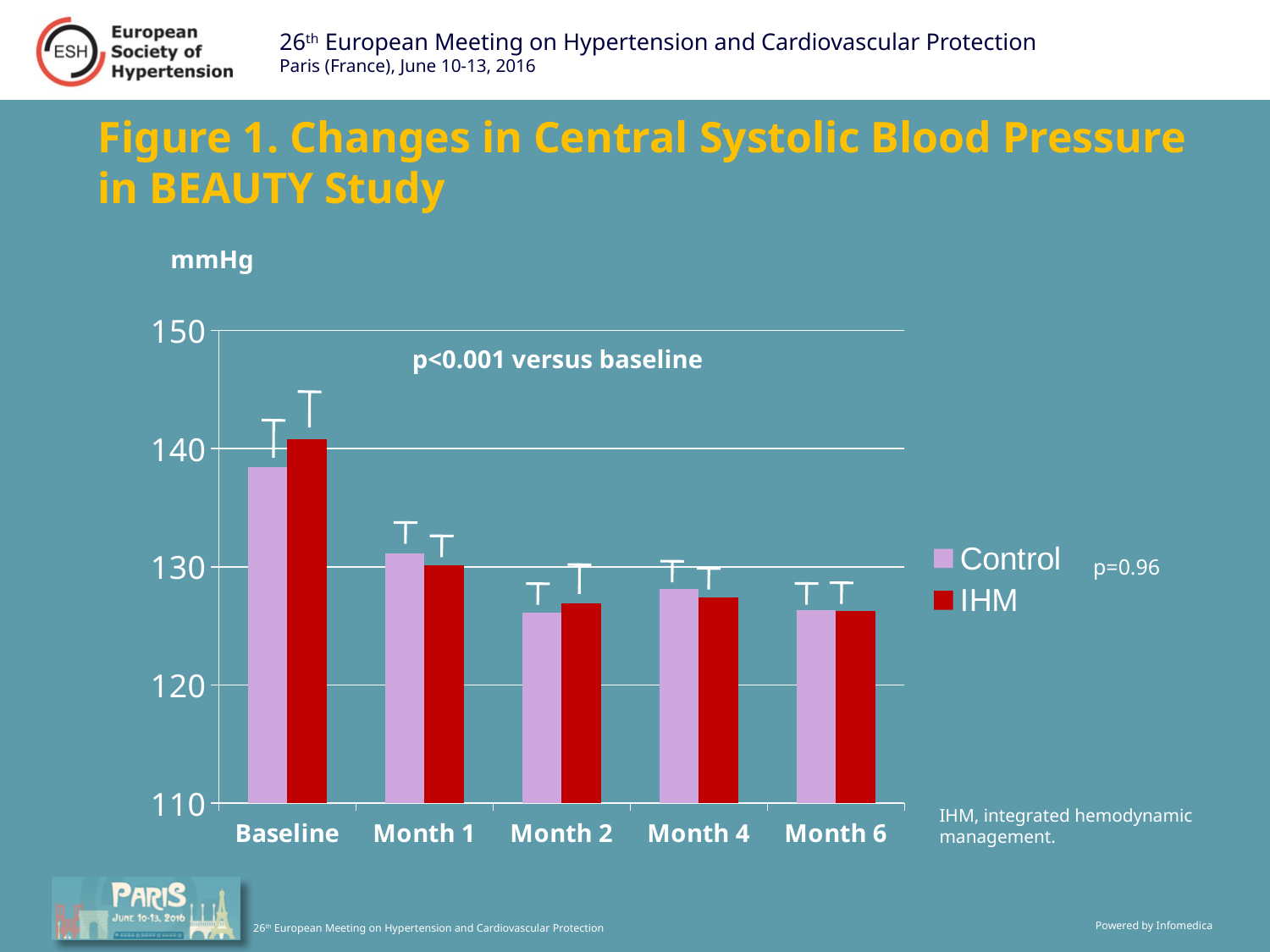
What unit is shown for the y axis of the chart? mmHg How many categories are shown along the x axis of the chart? 5 How many series does the chart's legend list? 2 Is the IHM value at Baseline greater or less than 140? greater Which series are listed in the chart's legend? Control and IHM Do the IHM values generally rise or fall from Baseline to Month 6? fall Is the Control value at Baseline greater or less than 140? less At which time point is the IHM value highest? Baseline At Baseline, which series has the larger value, Control or IHM? IHM At which time point is the Control value highest? Baseline What kind of chart is shown on the slide? bar chart Is the Control value at Month 2 greater or less than 130? less